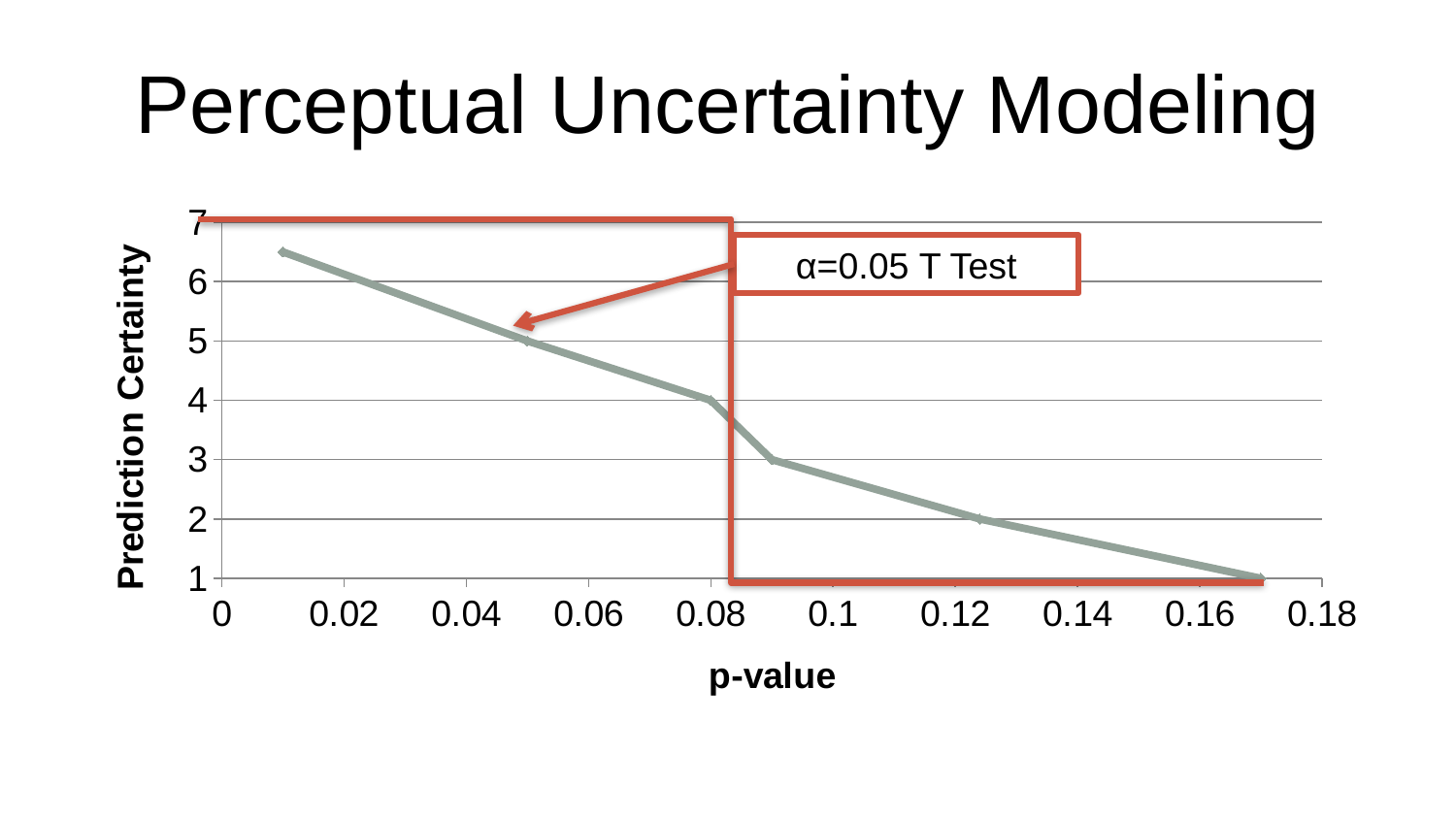
What is the label of the y axis? Prediction Certainty Which p-value has the higher Prediction Certainty, 0.01 or 0.17? 0.01 What is the Prediction Certainty at a p-value of 0.08? 4 What is the label of the x axis? p-value Is the Prediction Certainty at a p-value of 0.17 greater or less than 2? less What is the highest value shown on the x axis? 0.18 How many data points are plotted on the line? 6 What type of chart is shown on the slide? line chart Does Prediction Certainty rise or fall as the p-value increases? fall Is the Prediction Certainty at a p-value of 0.09 greater or less than 4? less Is the Prediction Certainty at a p-value of 0.01 greater or less than 6? greater